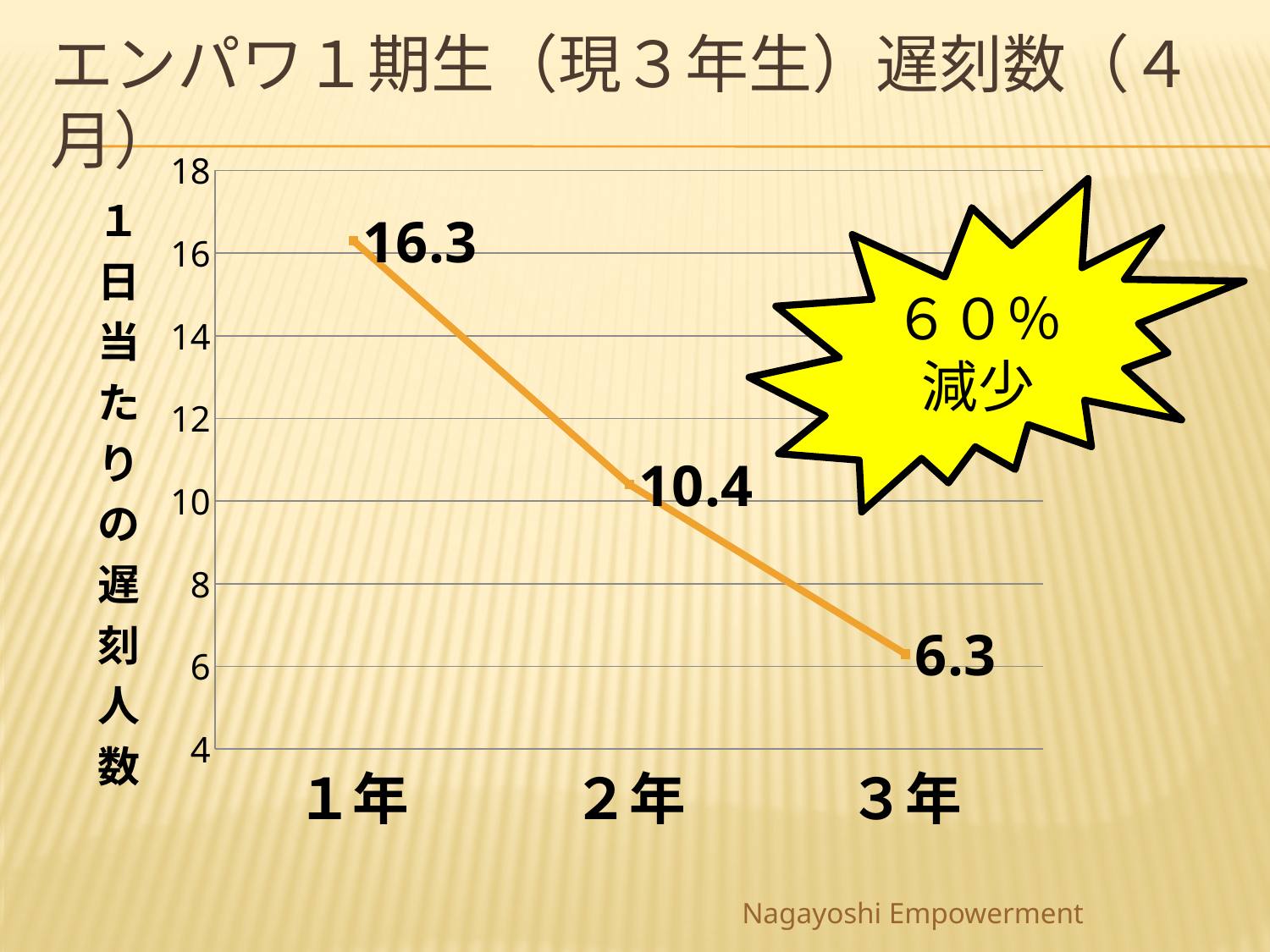
Is the value for 2年 greater or less than 12? less What kind of chart is shown on the slide? line chart What is the difference between the values for 1年 and 3年? 10.0 What is the value for 1年? 16.3 Which category has the lowest value? 3年 What is the value for 2年? 10.4 Do the values rise or fall from 1年 to 3年? fall How many categories are plotted on the x axis? 3 Which is larger, the value for 2年 or the value for 3年? 2年 What is the value for 3年? 6.3 What is the difference between the values for 1年 and 2年? 5.9 Which category has the highest value? 1年